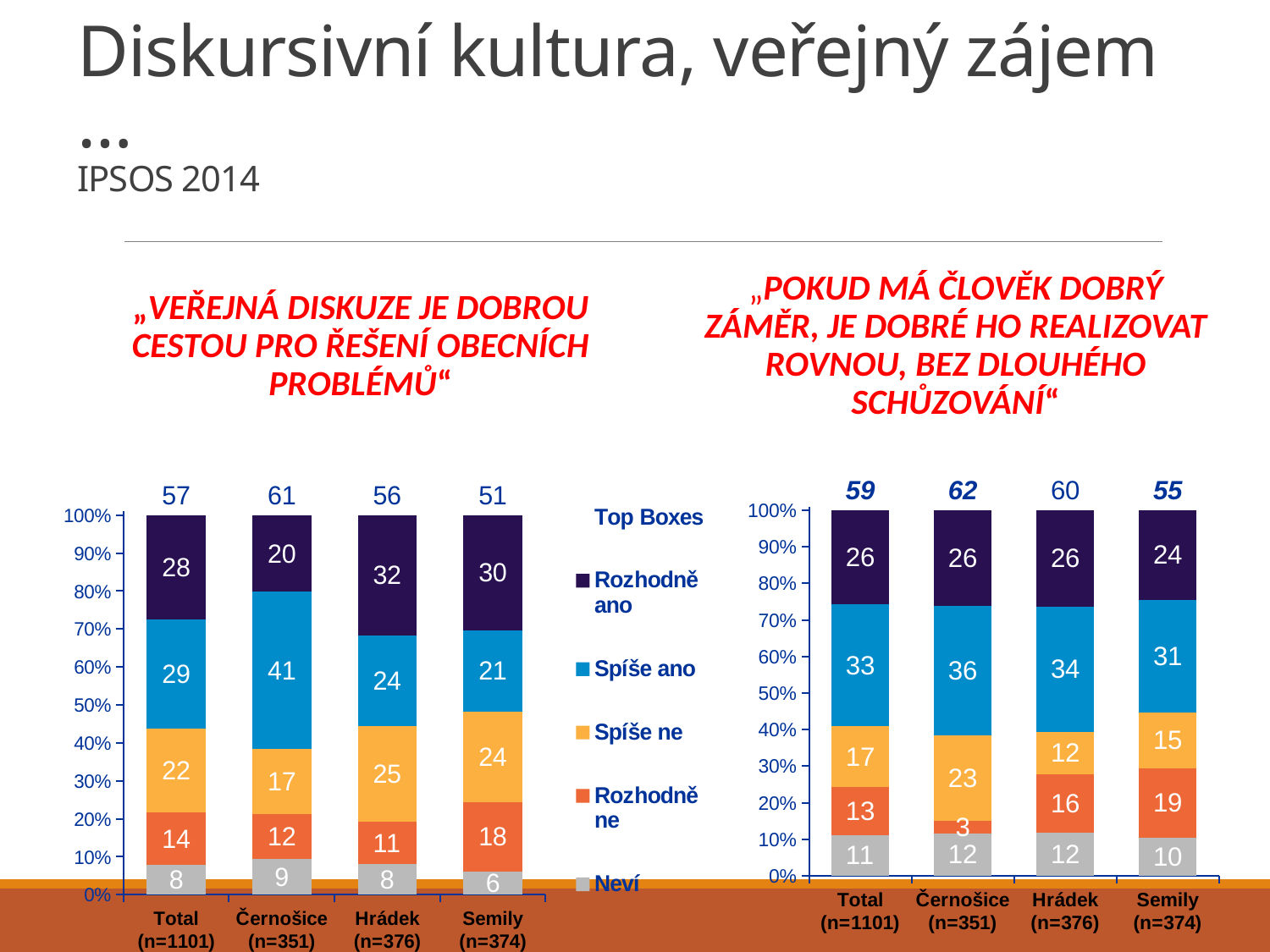
In the left chart, what is the "Neví" value for Semily (n=374)? 6 How many categories are shown on the x axis of the left chart? 4 In the right chart ("Pokud má člověk dobrý záměr..."), what is the value of "Rozhodně ne" for Černošice (n=351)? 3 What type of chart is the right chart ("Pokud má člověk dobrý záměr...")? Stacked bar chart In the left chart, what is the difference between the "Rozhodně ano" values for Hrádek (n=376) and Černošice (n=351)? 12 In the right chart, which is larger: the "Spíše ne" value for Černošice (n=351) or for Hrádek (n=376)? Černošice (n=351) In the right chart, which category has the lowest Top Boxes value shown above the bars? Semily (n=374) In the left chart ("Veřejná diskuze je dobrou cestou..."), what is the value of "Spíše ano" for Černošice (n=351)? 41 Which legend entry is shown in the darkest (navy) colour? Rozhodně ano In the left chart, which category has the highest Top Boxes value shown above the bars? Černošice (n=351) In the right chart, what is the Top Boxes value shown above the Total (n=1101) bar? 59 How many series does the legend between the two charts list? 6